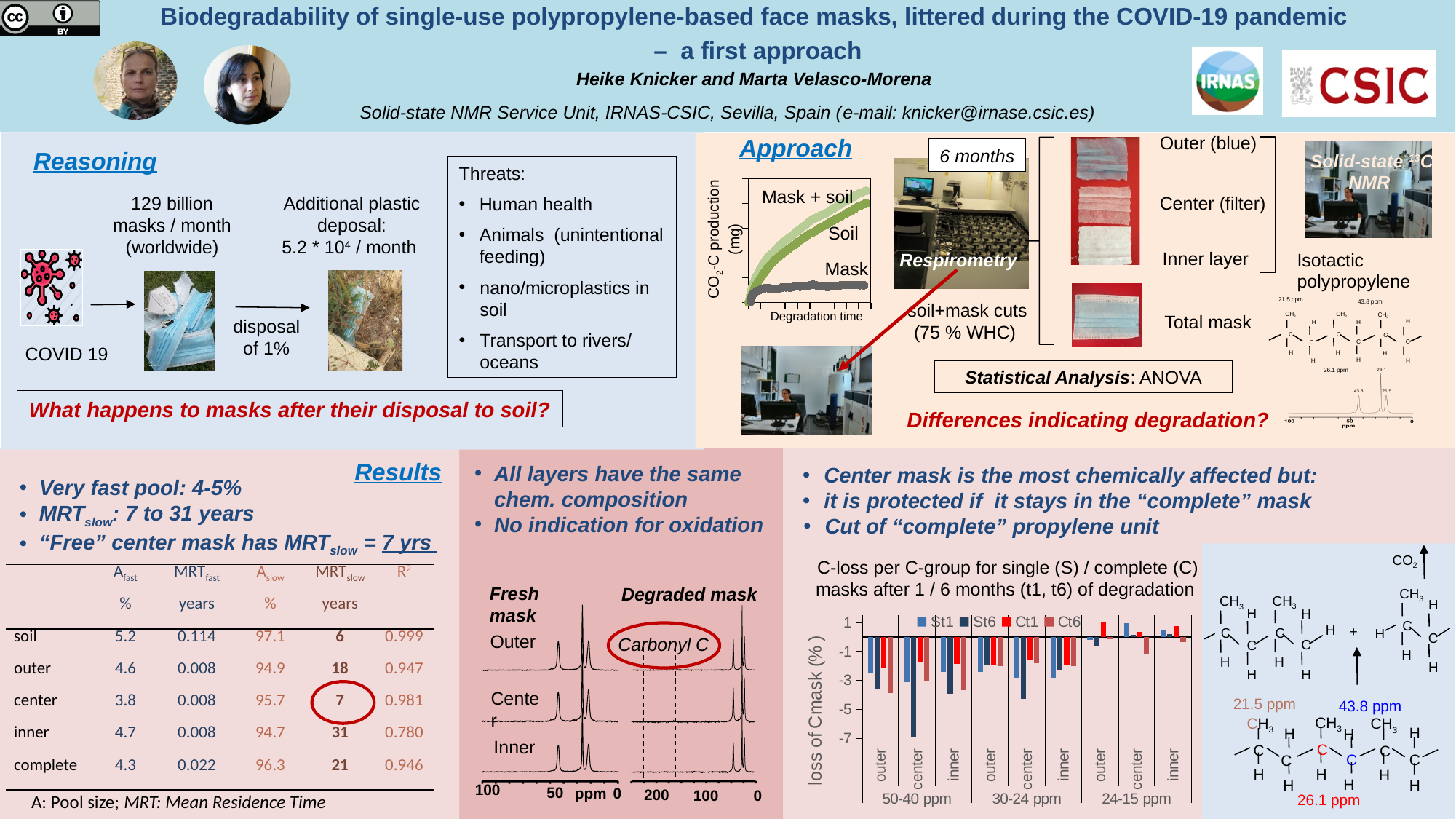
In the 'C-loss per C-group' bar chart, which layer and ppm group shows the largest C loss (the longest bar below zero)? center, 50-40 ppm What are the legend entries of the 'C-loss per C-group' bar chart? St1, St6, Ct1, Ct6 What is the y-axis label of the 'C-loss per C-group' bar chart? loss of Cmask (%) How many ppm groups are shown along the x axis of the 'C-loss per C-group' bar chart? 3 In the CO2-C production chart in the Approach section, which series reaches the highest value? Mask + soil In the 'C-loss per C-group' bar chart, is the St6 value for center in the 30-24 ppm group greater or less than -3? less In the 'C-loss per C-group' bar chart, is the St1 value for outer in the 24-15 ppm group greater or less than -3? greater In the 'C-loss per C-group' bar chart, which ppm group shows the smallest C losses overall? 24-15 ppm What kind of chart is the 'C-loss per C-group' chart at the bottom right of the slide? bar chart How many series does the legend of the 'C-loss per C-group' bar chart list? 4 In the 'C-loss per C-group' bar chart, is the St6 value for center in the 50-40 ppm group greater or less than -5? less How many layer categories (outer/center/inner positions) are plotted in total along the x axis of the 'C-loss per C-group' bar chart? 9